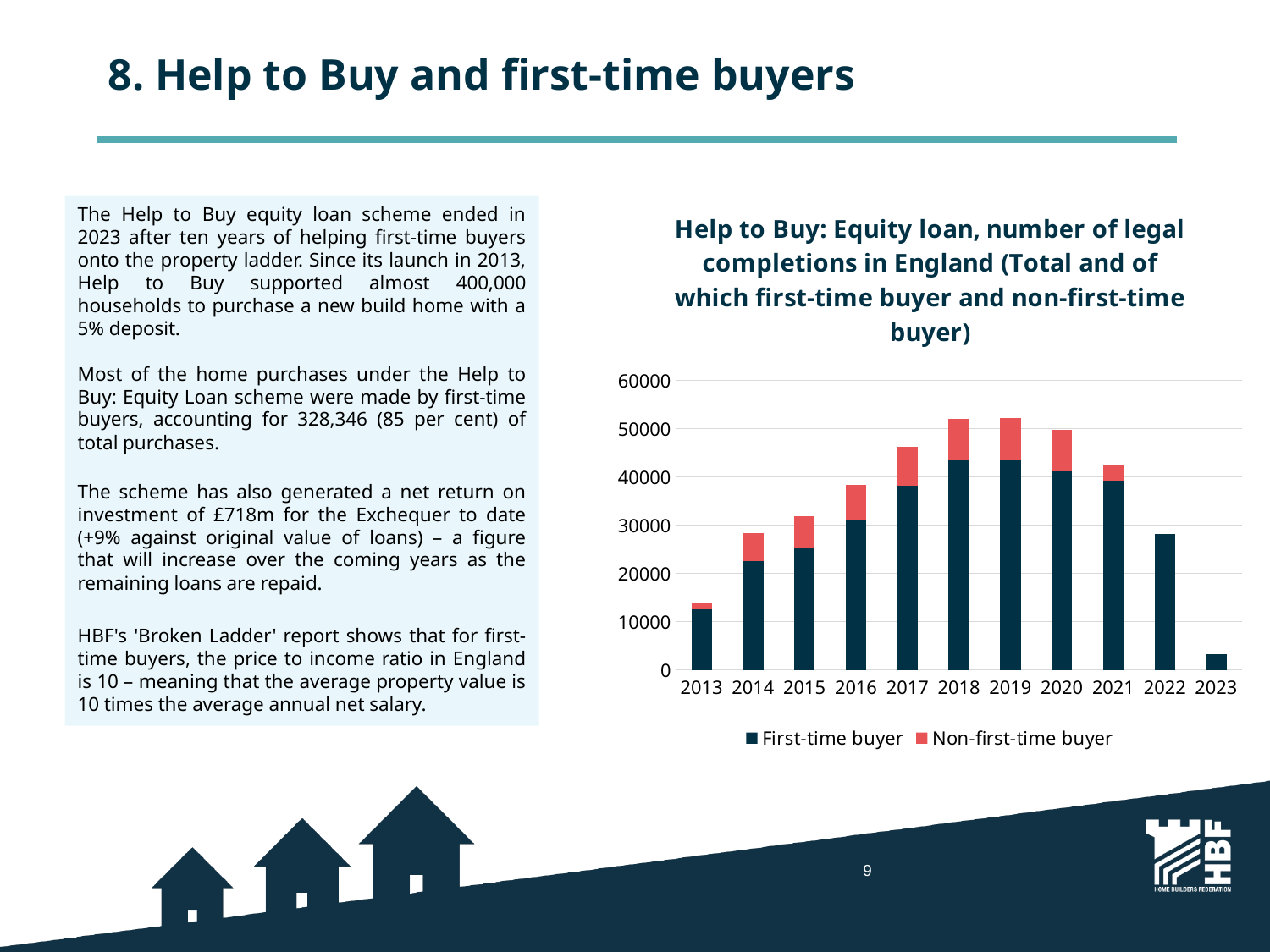
Is the total value for 2016 greater or less than 40000? less How many series does the chart legend list? 2 How many years are shown on the x axis of the chart? 11 Is the total value for 2022 greater or less than 30000? less Which year has the lowest total number of legal completions in the chart? 2023 What kind of chart is shown on the slide? Stacked bar chart Do the total completions rise or fall from 2013 to 2018? Rise Which year has the larger total number of completions, 2021 or 2022? 2021 Is the total value for 2023 greater or less than 10000? less Which colour represents the Non-first-time buyer series in the chart? Red